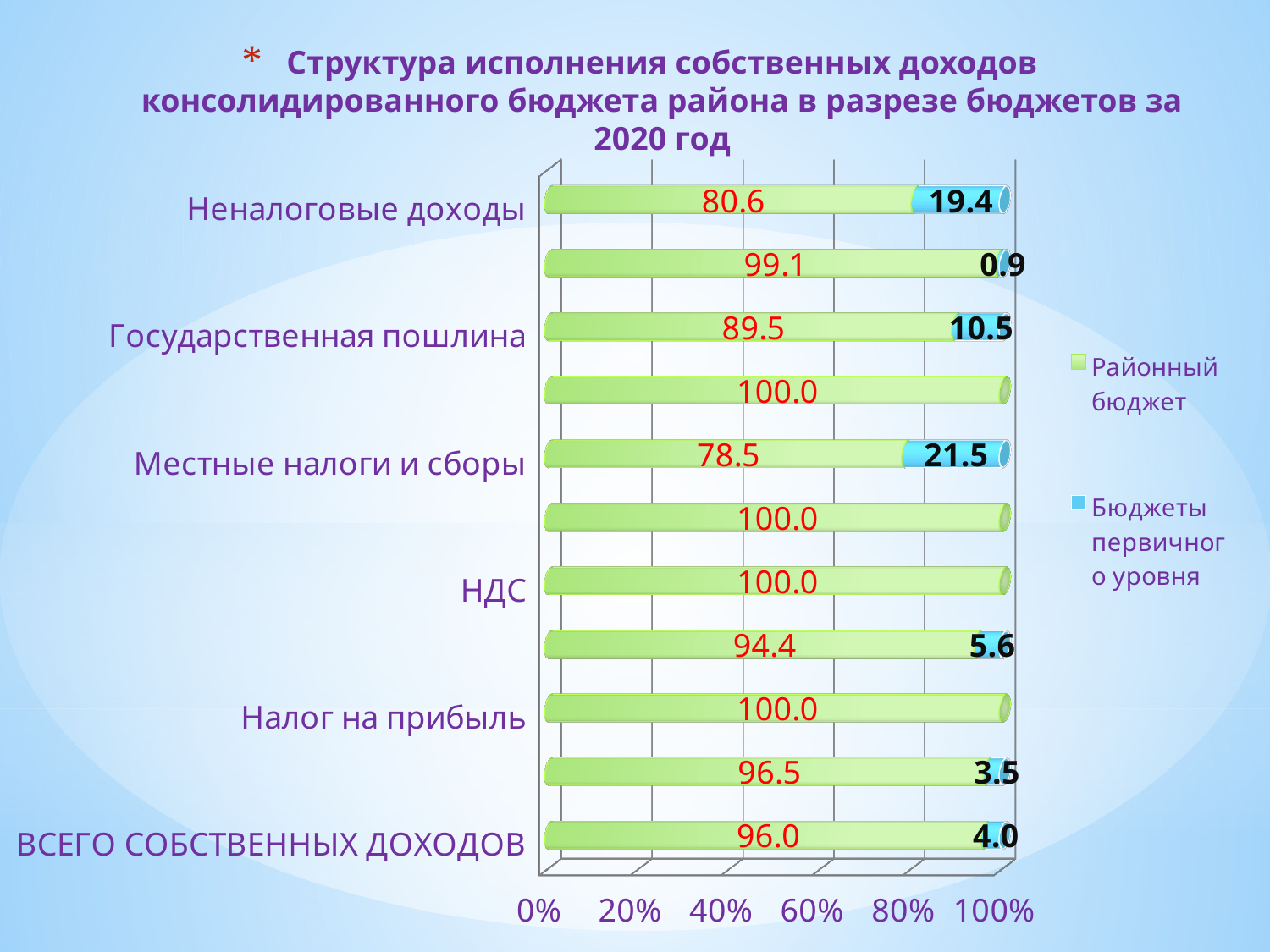
How many series does the legend list? 2 What is the value of Районный бюджет for ВСЕГО СОБСТВЕННЫХ ДОХОДОВ? 96.0 What is the value of Бюджеты первичного уровня for Местные налоги и сборы? 21.5 Which category has the highest value for Бюджеты первичного уровня? Местные налоги и сборы What is the difference between the Районный бюджет values for Неналоговые доходы and Местные налоги и сборы? 2.1 What is the value of Бюджеты первичного уровня for Государственная пошлина? 10.5 What is the value of Районный бюджет for Неналоговые доходы? 80.6 What kind of chart is shown on the slide? Stacked bar chart What is the total of the stacked bar for Неналоговые доходы? 100.0 What is the value of Районный бюджет for НДС? 100.0 Which category has the lowest value for Районный бюджет? Местные налоги и сборы Which has the larger Бюджеты первичного уровня value: Неналоговые доходы or Государственная пошлина? Неналоговые доходы